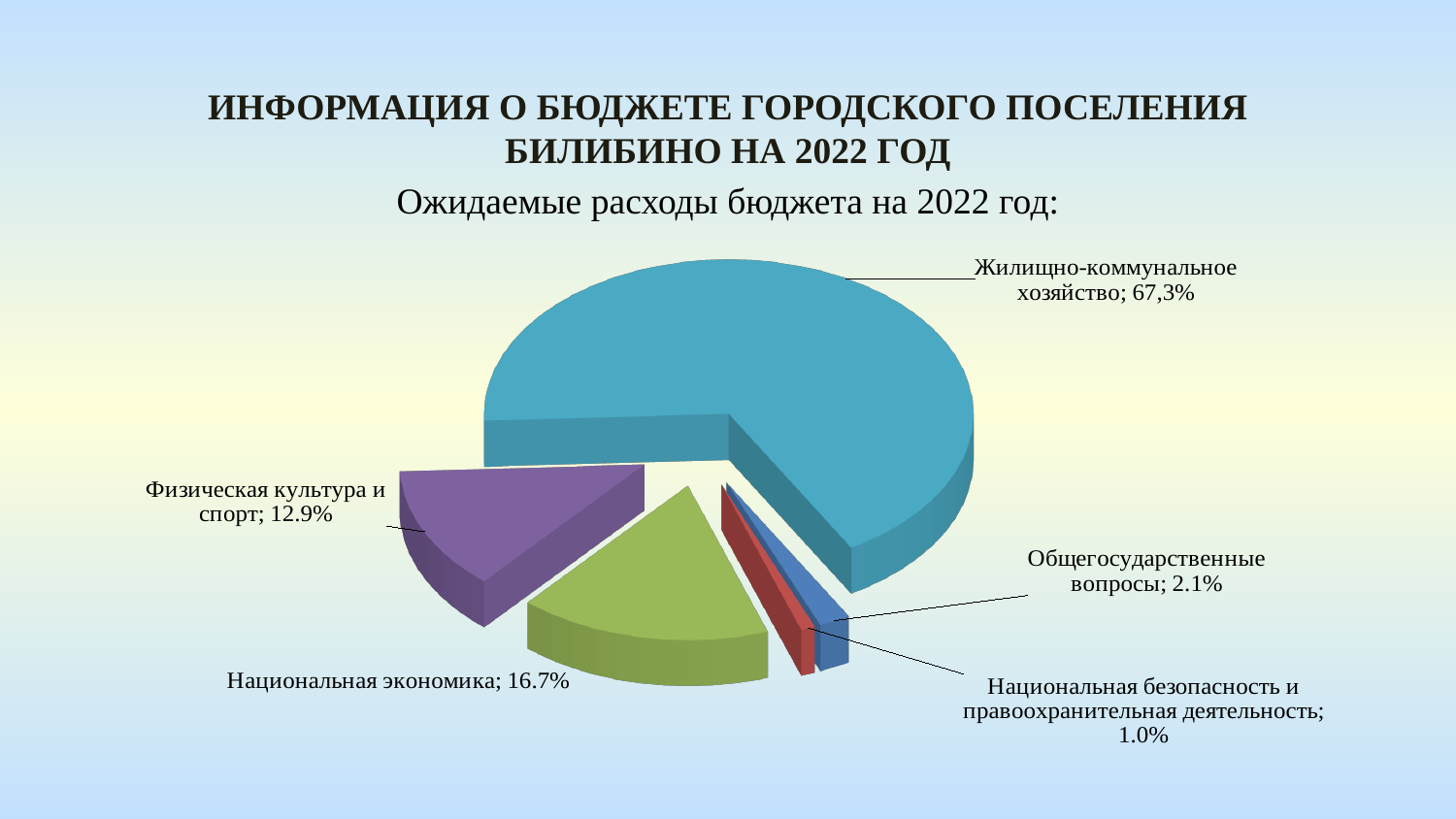
Which is larger: Национальная экономика or Физическая культура и спорт? Национальная экономика What is the value shown for Физическая культура и спорт? 12.9% What share of expected 2022 budget expenditures goes to Жилищно-коммунальное хозяйство? 67,3% What is the value shown for Общегосударственные вопросы? 2.1% Which category has the largest share of the pie? Жилищно-коммунальное хозяйство What colour is the slice for Национальная экономика? Green What is the value shown for Национальная безопасность и правоохранительная деятельность? 1.0% What is the value shown for Национальная экономика? 16.7% What is the difference in percentage points between Национальная экономика and Физическая культура и спорт? 3.8 What kind of chart is shown on the slide? Pie chart Which category has the smallest share of the pie? Национальная безопасность и правоохранительная деятельность How many slices does the pie chart have? 5